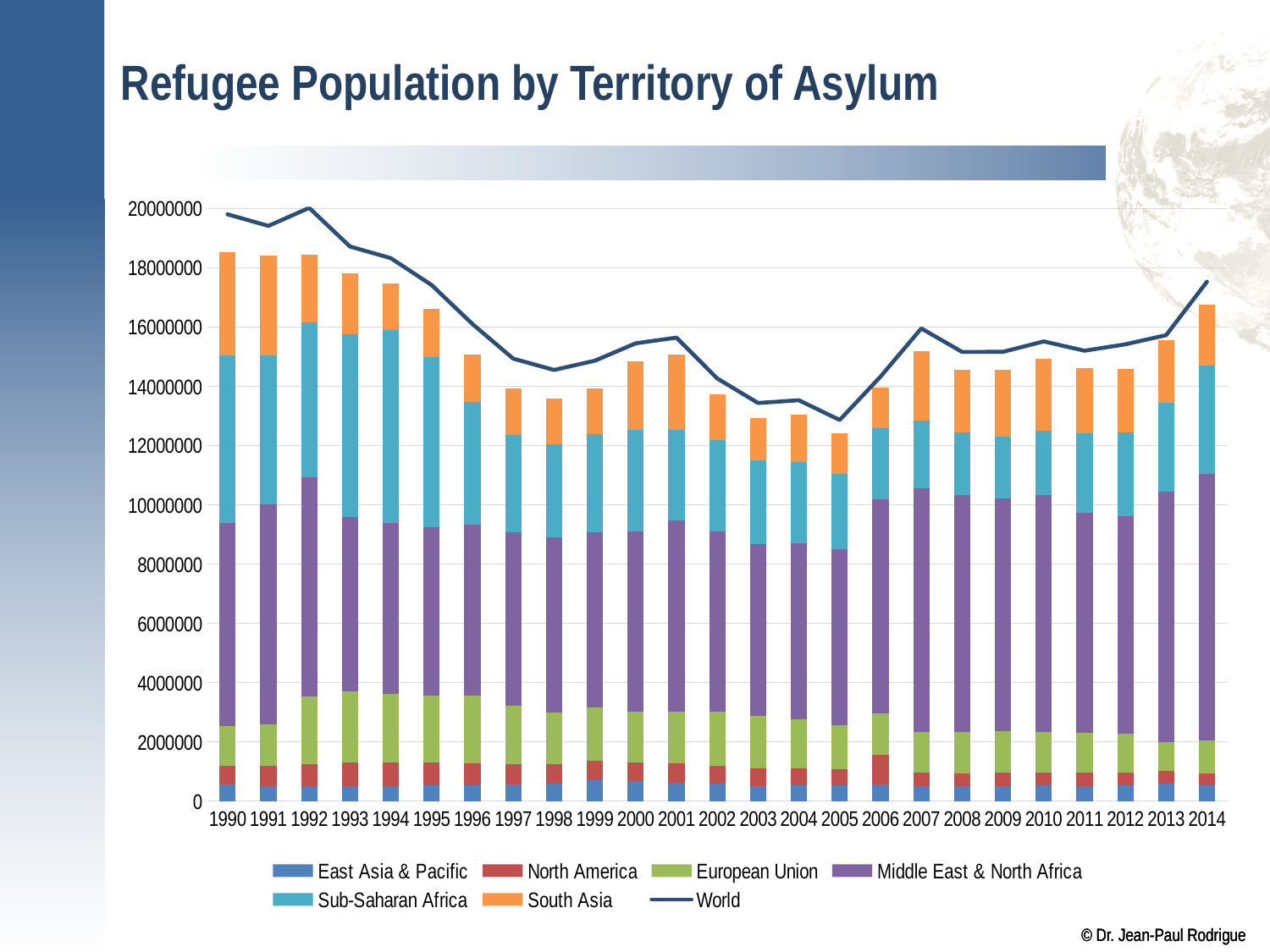
How many series does the legend list? 7 Which series is drawn as a line rather than as stacked bars? World What kind of chart is shown on the slide? Stacked bar chart with a line How many years are shown along the x axis? 25 Which year has the larger World value, 2014 or 2005? 2014 In which year does the World line reach its lowest value? 2005 Is the total height of the stacked bar for 1990 greater or less than 18000000? greater What is the title of the chart? Refugee Population by Territory of Asylum Is the World value for 2005 greater or less than 14000000? less In which year does the World line reach its highest value? 1992 Is the World value for 1992 greater or less than 18000000? greater Does the World line rise or fall between 1992 and 1998? fall